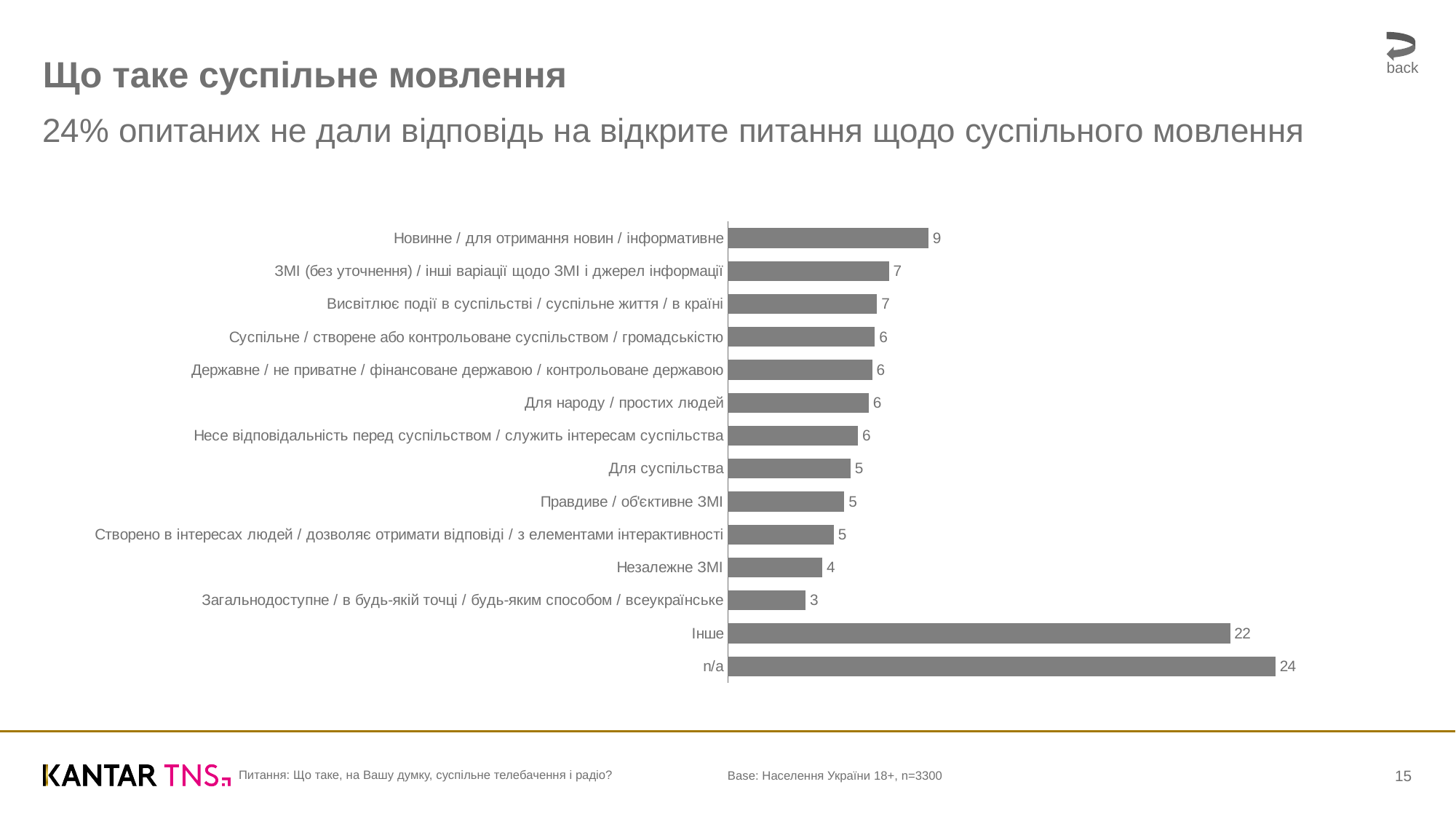
What is the value for "Незалежне ЗМІ"? 4 What is the difference between the values for "n/a" and "Інше"? 2 What is the value for "n/a"? 24 Which category has the lowest value? Загальнодоступне / в будь-якій точці / будь-яким способом / всеукраїнське What is the value for "Для суспільства"? 5 How many categories are shown in the chart? 14 Which is larger, the value for "Інше" or the value for "Новинне / для отримання новин / інформативне"? Інше What is the value for "Новинне / для отримання новин / інформативне"? 9 What is the difference between the values for "Новинне / для отримання новин / інформативне" and "Незалежне ЗМІ"? 5 What kind of chart is shown on the slide? Bar chart Which category has the highest value? n/a What is the value for "Інше"? 22